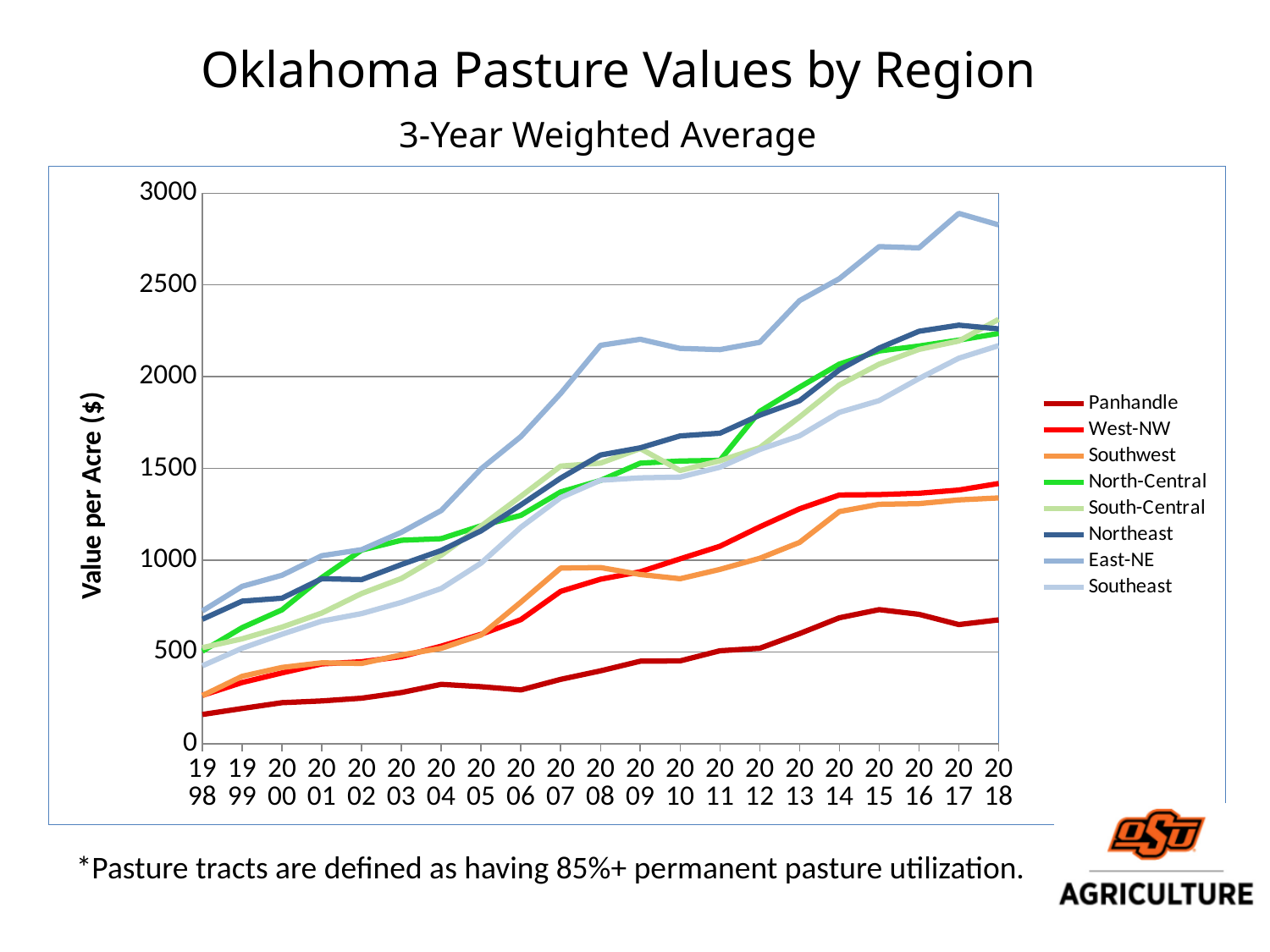
In 2010, which is larger: the value for West-NW or the value for Panhandle? West-NW Is the value for Northeast in 2018 greater or less than 2000? greater What kind of chart is shown on the slide? line chart Does the East-NE line generally rise or fall from 1998 to 2018? rise Which region has the lowest pasture value in 2018? Panhandle What is the label on the y axis? Value per Acre ($) Which region has the highest pasture value in 2018? East-NE How many regions (series) does the legend list? 8 Is the value for Panhandle in 2018 greater or less than 1000? less How many years are plotted along the x axis? 21 Is the value for East-NE in 2017 greater or less than 2500? greater